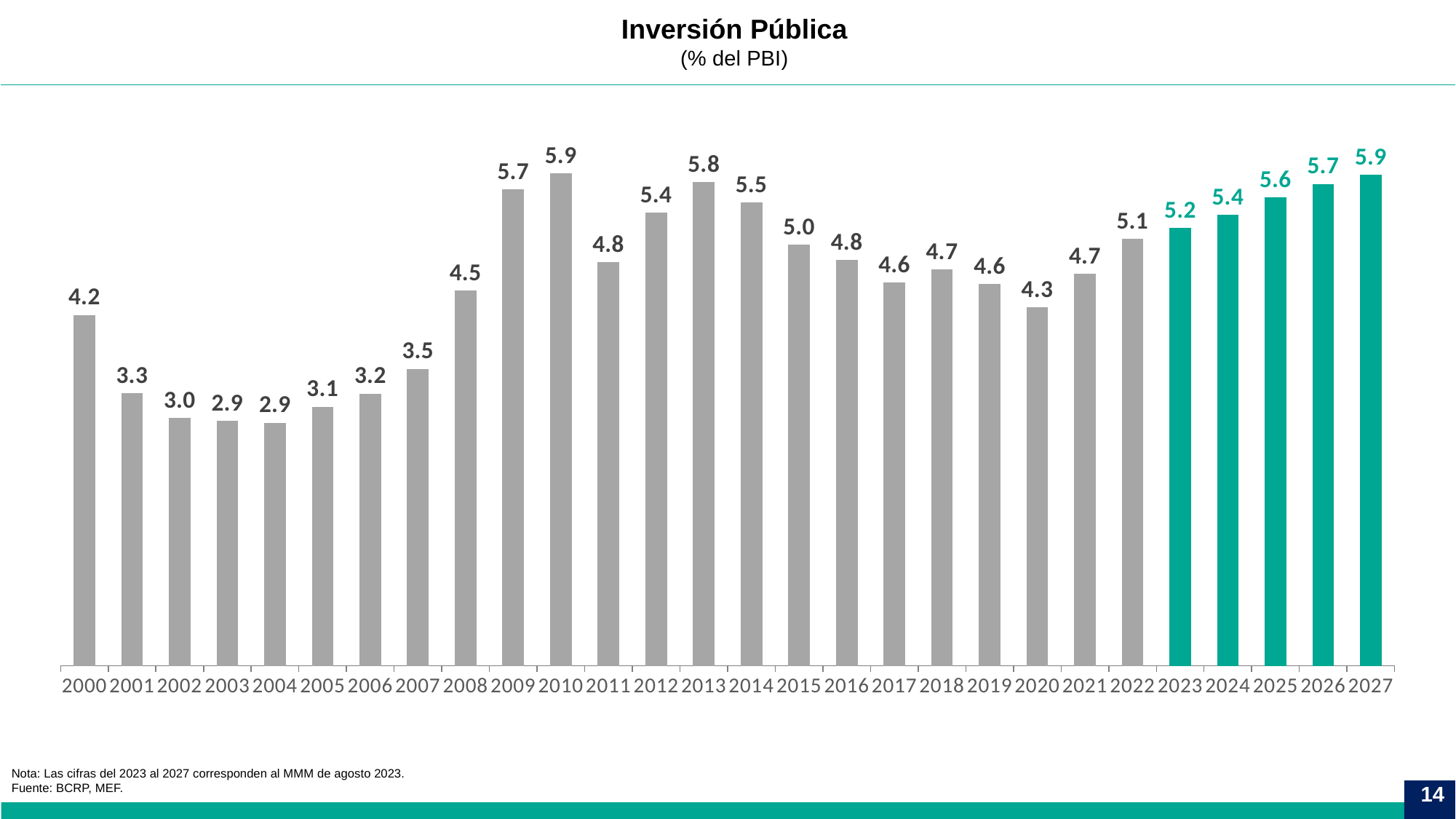
What is the value for 2013? 5.8 What is the value for 2000? 4.2 What is the difference between the values for 2010 and 2011? 1.1 What is the value for 2027? 5.9 How many years are shown on the x axis? 28 Do the values rise or fall from 2023 to 2027? rise What is the title of the chart? Inversión Pública Which is larger, the value for 2009 or the value for 2012? 2009 What kind of chart is shown on the slide? bar chart What is the value for 2020? 4.3 Which is larger, the value for 2001 or the value for 2007? 2007 What is the difference between the values for 2022 and 2000? 0.9